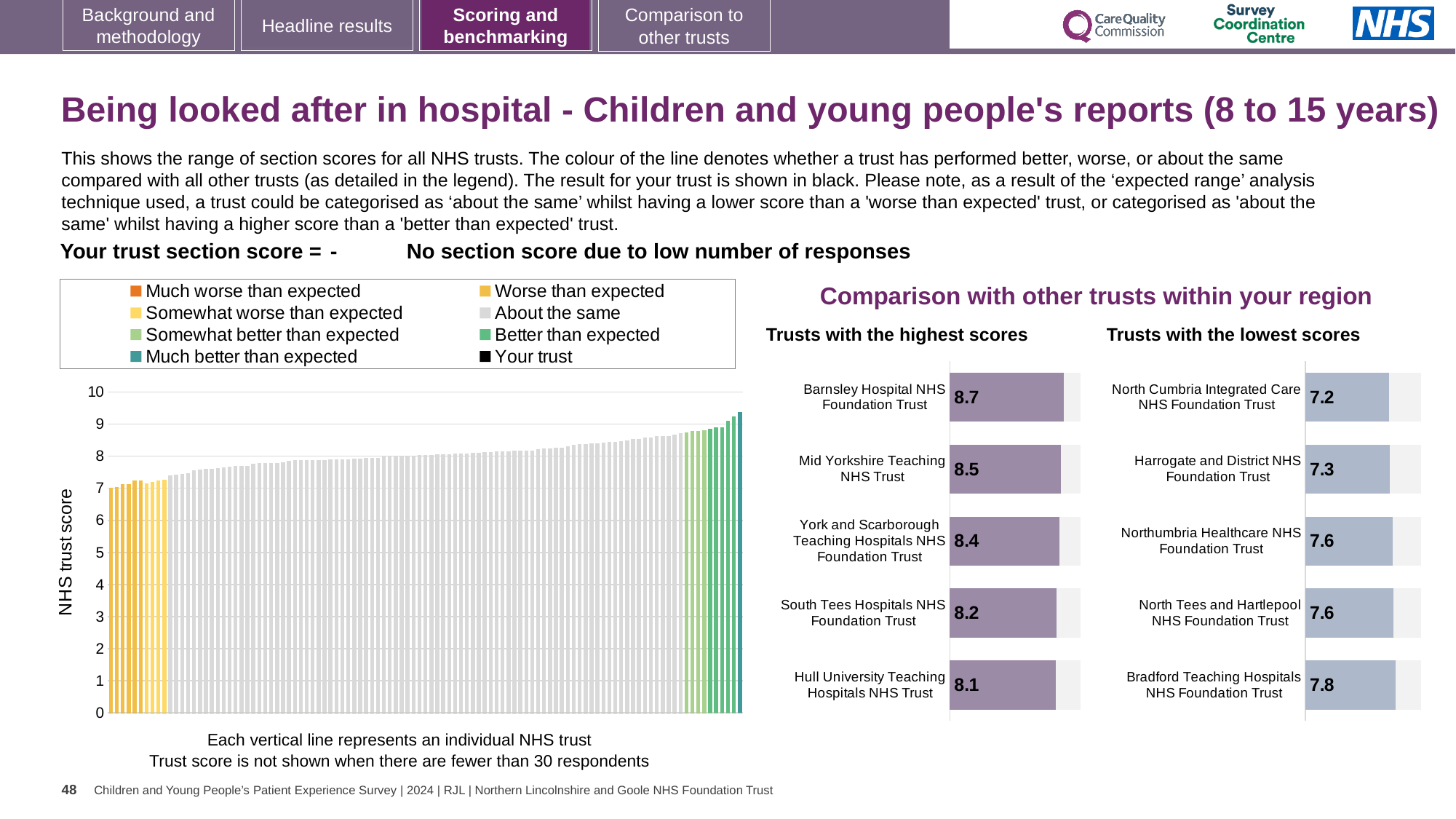
In the 'Trusts with the highest scores' chart, which trust has the highest score? Barnsley Hospital NHS Foundation Trust How many entries does the legend of the NHS trust score chart on the left list? 8 In the NHS trust score chart on the left, do the values rise or fall from left to right? Rise In the 'Trusts with the highest scores' chart, what is the score for Barnsley Hospital NHS Foundation Trust? 8.7 How many trusts are listed in the 'Trusts with the lowest scores' chart? 5 In the 'Trusts with the lowest scores' chart, what is the score for Bradford Teaching Hospitals NHS Foundation Trust? 7.8 In the 'Trusts with the lowest scores' chart, which has the higher score: Harrogate and District NHS Foundation Trust or Northumbria Healthcare NHS Foundation Trust? Northumbria Healthcare NHS Foundation Trust In the 'Trusts with the lowest scores' chart, what is the score for North Cumbria Integrated Care NHS Foundation Trust? 7.2 In the 'Trusts with the highest scores' chart, what is the score for Hull University Teaching Hospitals NHS Trust? 8.1 In the 'Trusts with the highest scores' chart, what is the difference between the scores of Barnsley Hospital NHS Foundation Trust and South Tees Hospitals NHS Foundation Trust? 0.5 In the 'Trusts with the lowest scores' chart, which trust has the lowest score? North Cumbria Integrated Care NHS Foundation Trust What kind of chart is the NHS trust score chart on the left of the slide? Bar chart